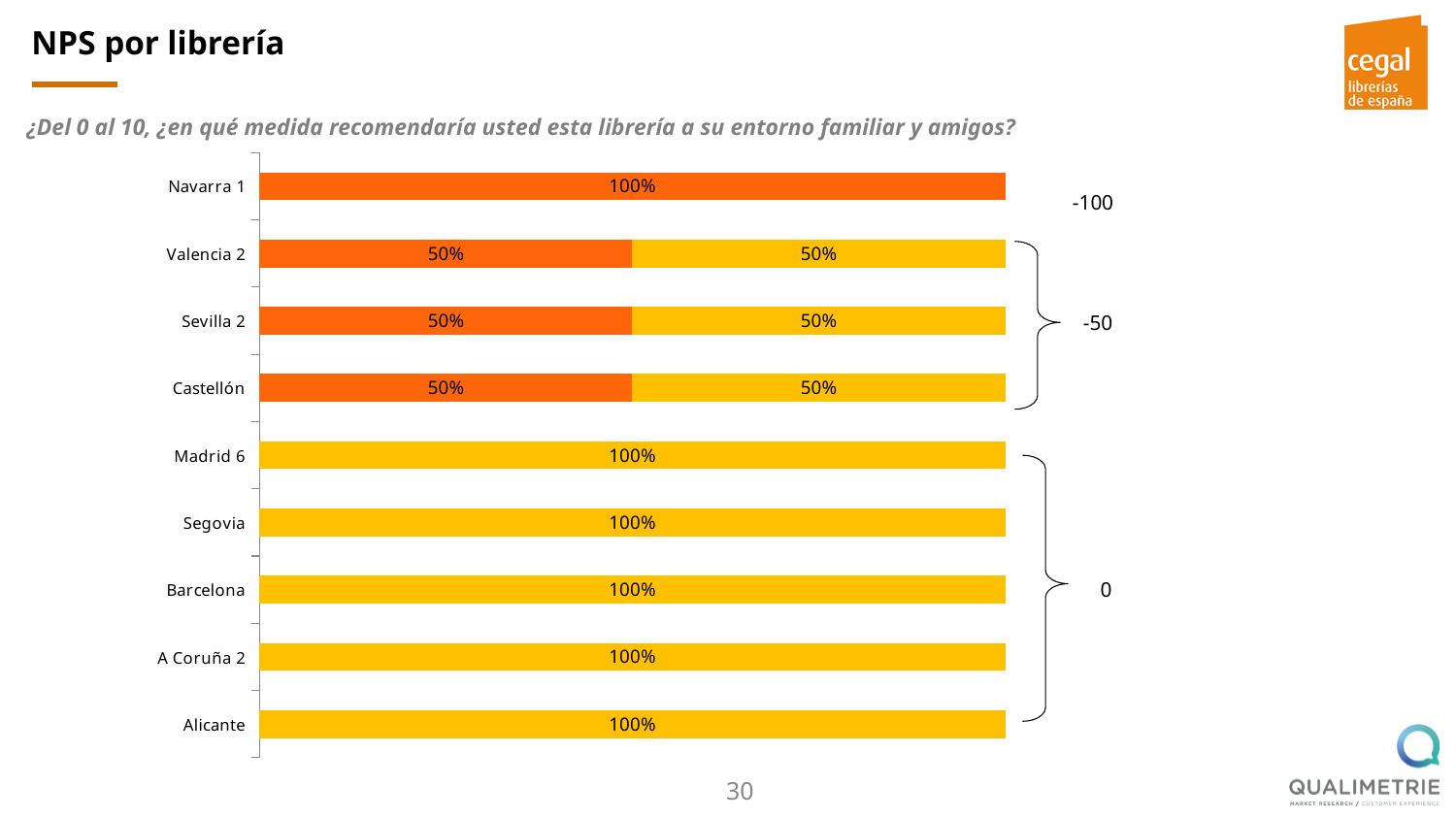
What is the difference between the orange segment for Navarra 1 and the orange segment for Castellón? 50% What is the title of the chart on the slide? NPS por librería What is the value of the yellow segment for Sevilla 2? 50% What is the value of the orange segment for Valencia 2? 50% What kind of chart is shown on the slide? bar chart What is the total of the stacked bar for Castellón? 100% What is the value of the orange segment for Navarra 1? 100% What is the value of the yellow segment for Madrid 6? 100% What NPS value is annotated next to the bracket grouping Valencia 2, Sevilla 2 and Castellón? -50 Which is larger: the orange segment for Navarra 1 or the orange segment for Valencia 2? Navarra 1 How many librerías (categories) are listed on the chart? 9 What NPS value is annotated next to Navarra 1? -100